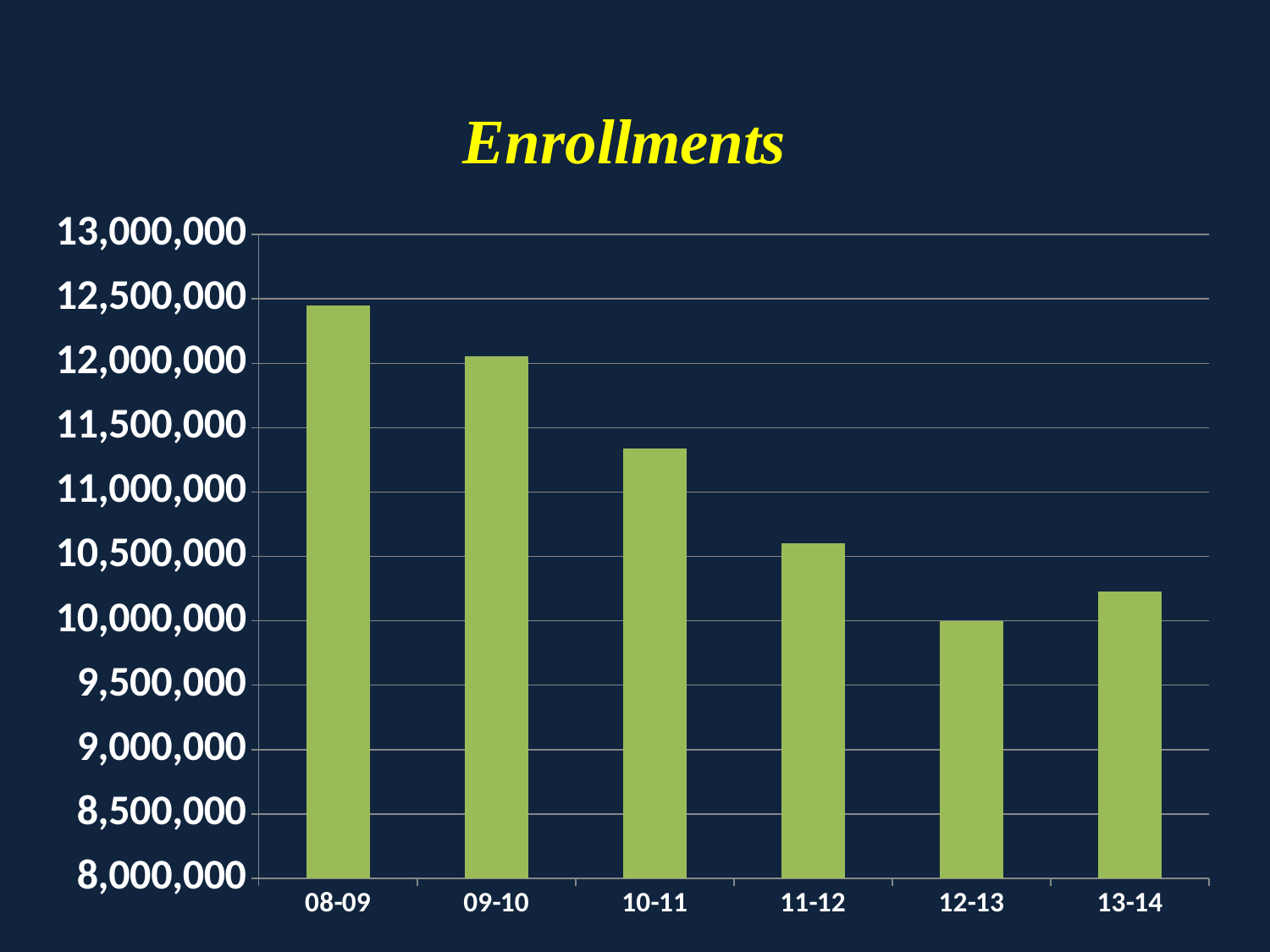
Is the value for 09-10 greater or less than 12,500,000? less What is the title of the chart? Enrollments Which school year has the highest enrollment? 08-09 Which school year has the lowest enrollment? 12-13 Is the value for 08-09 greater or less than 12,000,000? greater What kind of chart is shown on the slide? bar chart How many school years are shown on the x axis? 6 Is the value for 13-14 greater or less than 10,000,000? greater Which has the larger enrollment, 12-13 or 13-14? 13-14 From 08-09 to 12-13, do enrollments rise or fall? fall